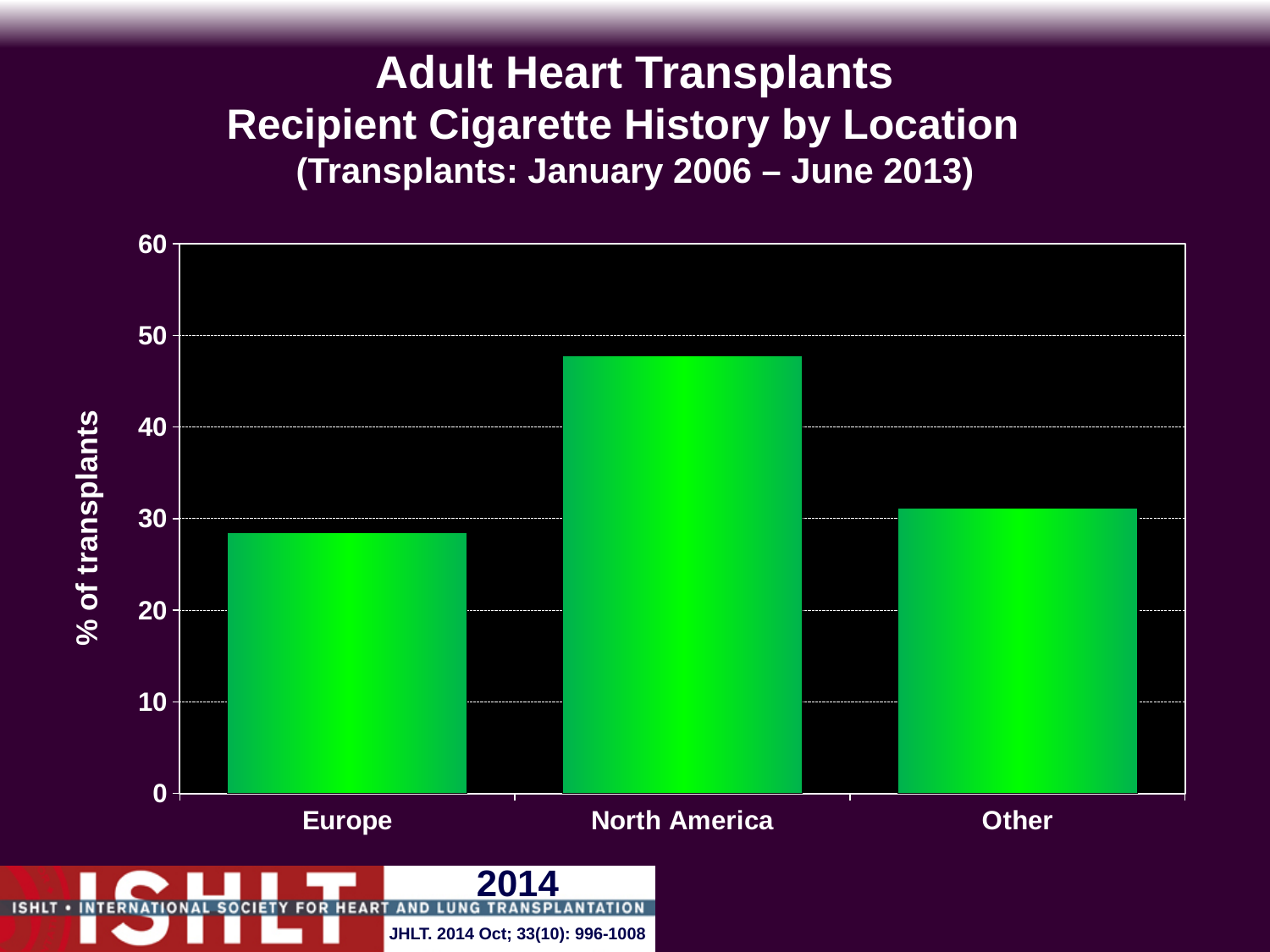
What time period of transplants does the chart title say the data covers? January 2006 – June 2013 Is the value for Other greater or less than 40? less Which has a higher value, Europe or Other? Other Is the value for North America greater or less than 40? greater What kind of chart is shown on the slide? bar chart Is the value for Europe greater or less than 30? less Which location has the lowest percentage of transplants with recipient cigarette history? Europe How many location categories are shown on the x axis? 3 Which has a higher value, North America or Other? North America What is the label on the y axis? % of transplants Which location has the highest percentage of transplants with recipient cigarette history? North America